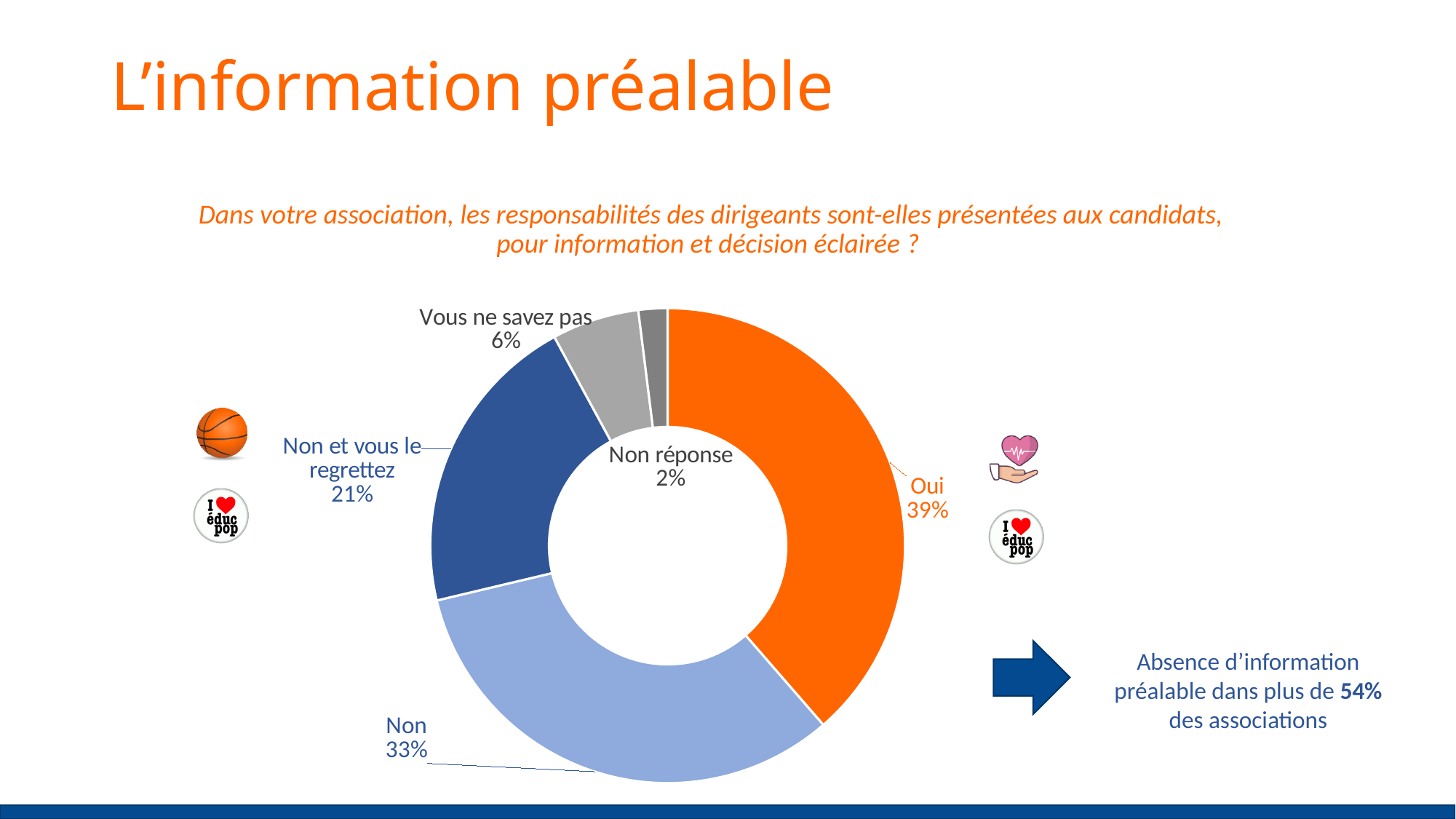
How many response categories are shown in the chart? 5 What percentage of respondents answered "Oui"? 39% Which is larger, the share for "Non" or the share for "Non et vous le regrettez"? Non What colour is the "Oui" slice of the chart? Orange Which response has the largest share of the chart? Oui What percentage is shown for "Non réponse"? 2% Which response has the smallest share of the chart? Non réponse What type of chart is shown on the slide? Doughnut chart What percentage of respondents answered "Non"? 33% What percentage is shown for "Vous ne savez pas"? 6% What share is shown for "Non et vous le regrettez"? 21% What is the difference in percentage points between "Oui" and "Non"? 6